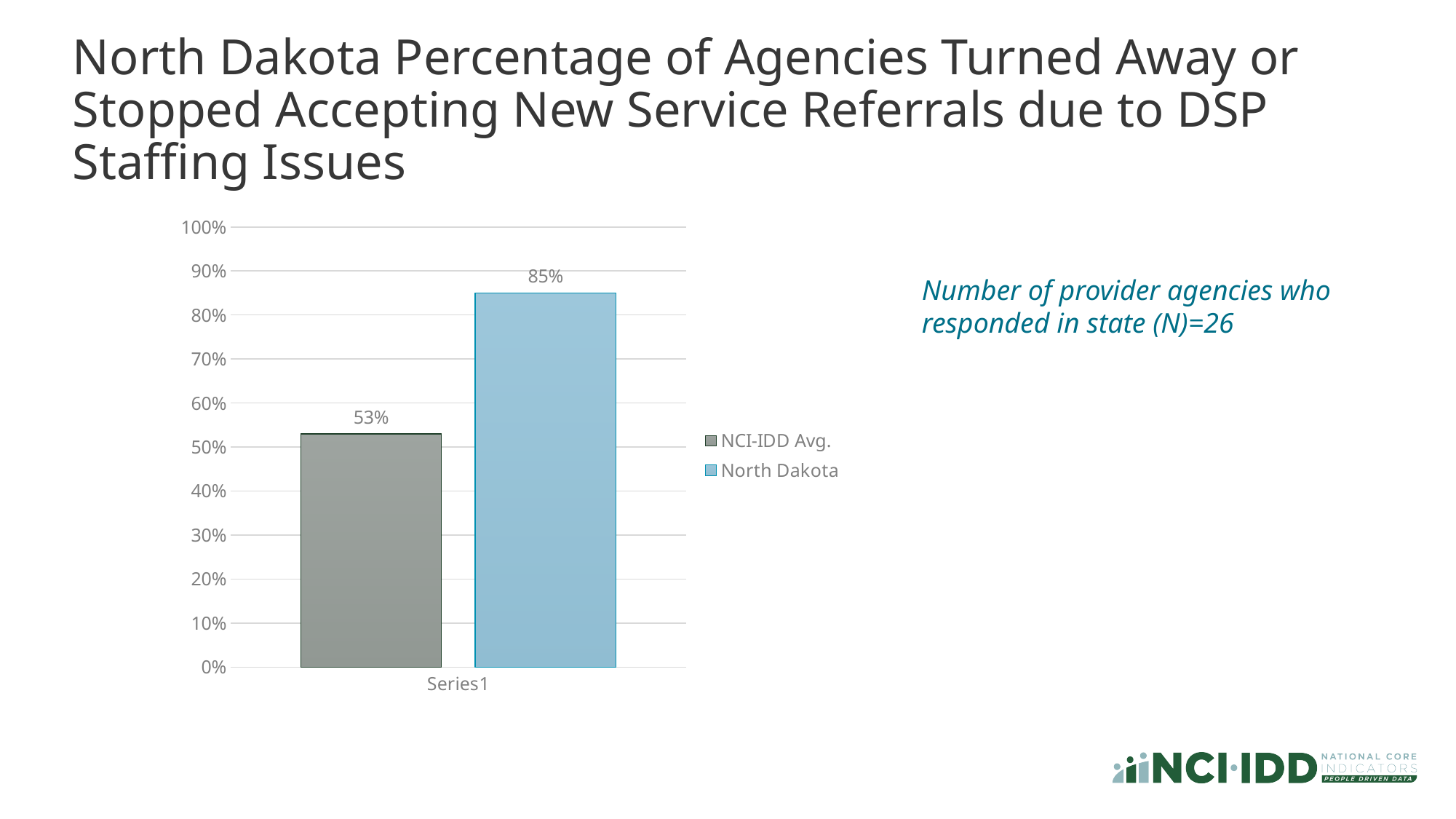
How many bars are plotted in the chart? 2 What kind of chart is shown on the slide? Bar chart Which series has the higher value, NCI-IDD Avg. or North Dakota? North Dakota What is the value for NCI-IDD Avg.? 53% Which series has the lowest value? NCI-IDD Avg. What is the maximum value shown on the vertical axis? 100% Is the value for NCI-IDD Avg. greater or less than 60%? less What is the difference between the North Dakota value and the NCI-IDD Avg. value? 32% What is the value for North Dakota? 85% How many series does the legend list? 2 Is the value for North Dakota greater or less than 80%? greater What is the category label shown on the horizontal axis? Series1